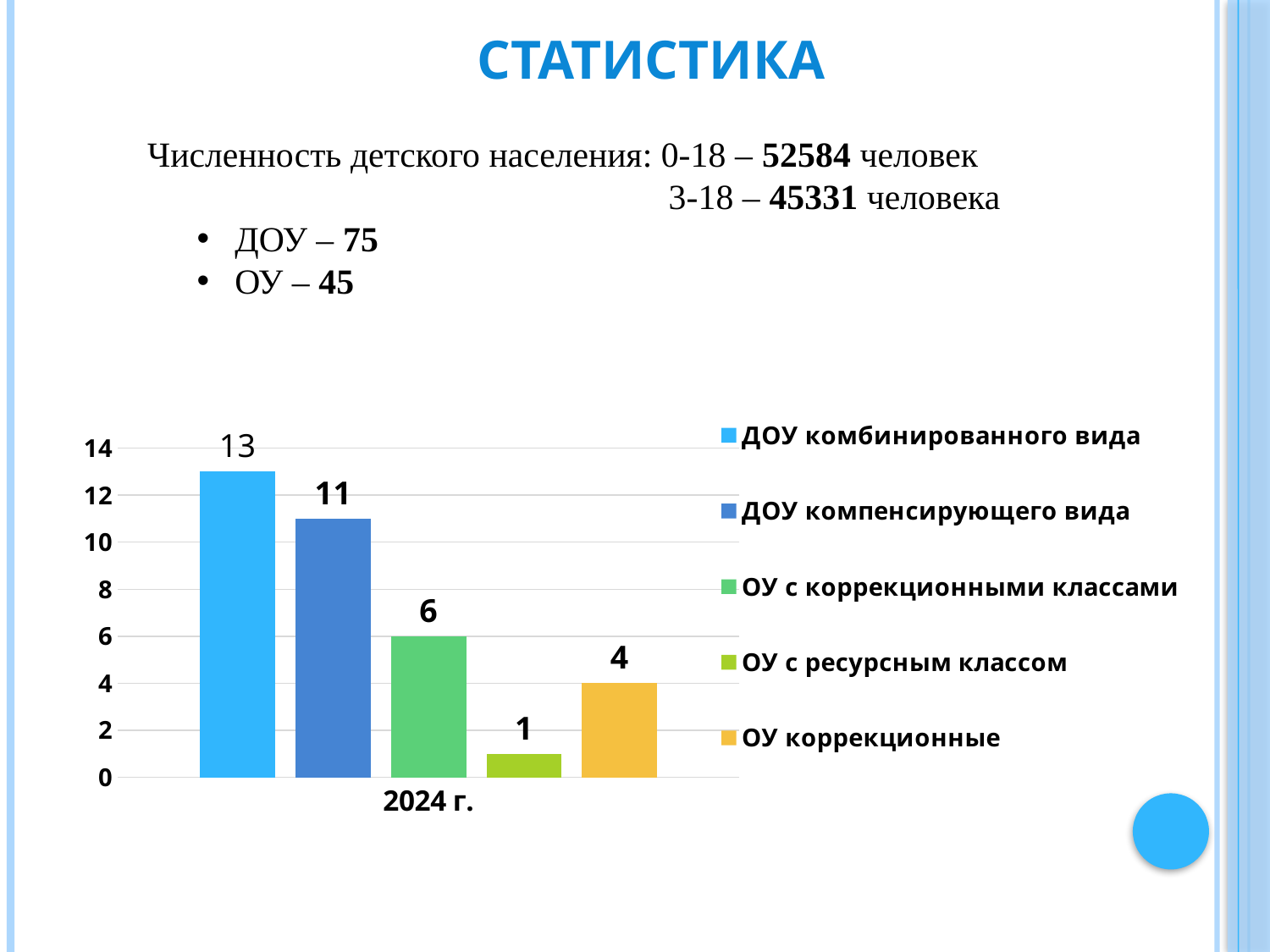
Which is larger: the value for ОУ с коррекционными классами or the value for ОУ коррекционные? ОУ с коррекционными классами What is the value for ДОУ компенсирующего вида in 2024 г.? 11 What is the value for ОУ коррекционные in 2024 г.? 4 Which series has the lowest value in the chart? ОУ с ресурсным классом How many series does the legend list? 5 What is the difference between the values for ДОУ комбинированного вида and ДОУ компенсирующего вида? 2 What is the value for ОУ с коррекционными классами in 2024 г.? 6 Which series has the highest value in the chart? ДОУ комбинированного вида What kind of chart is shown on the slide? Bar chart What is the value for ОУ с ресурсным классом in 2024 г.? 1 What is the category label shown on the x axis of the chart? 2024 г. What is the value for ДОУ комбинированного вида in 2024 г.? 13